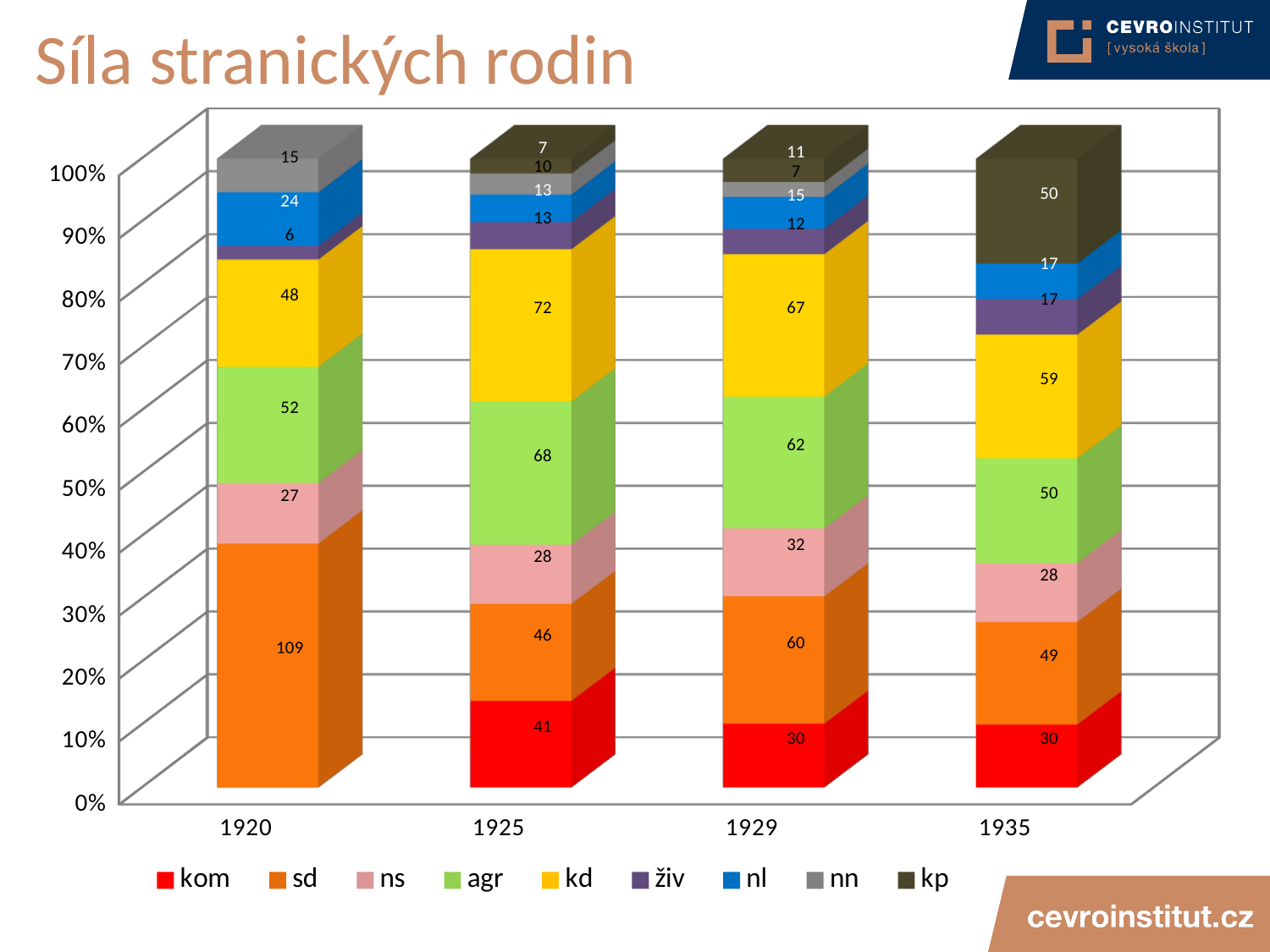
Which is larger, the value for agr in 1925 or the value for agr in 1935? agr in 1925 What is the difference between the kd values in 1925 and 1935? 13 How many years are shown on the x axis? 4 What is the value for agr in 1929? 62 What is the value for kp in 1935? 50 What is the value for sd in 1920? 109 In which year is the value for sd the highest? 1920 How many series does the legend list? 9 What is the title of the chart? Síla stranických rodin What kind of chart is shown on the slide? stacked bar chart In which year is the value for kp the highest? 1935 What is the value for kd in 1925? 72